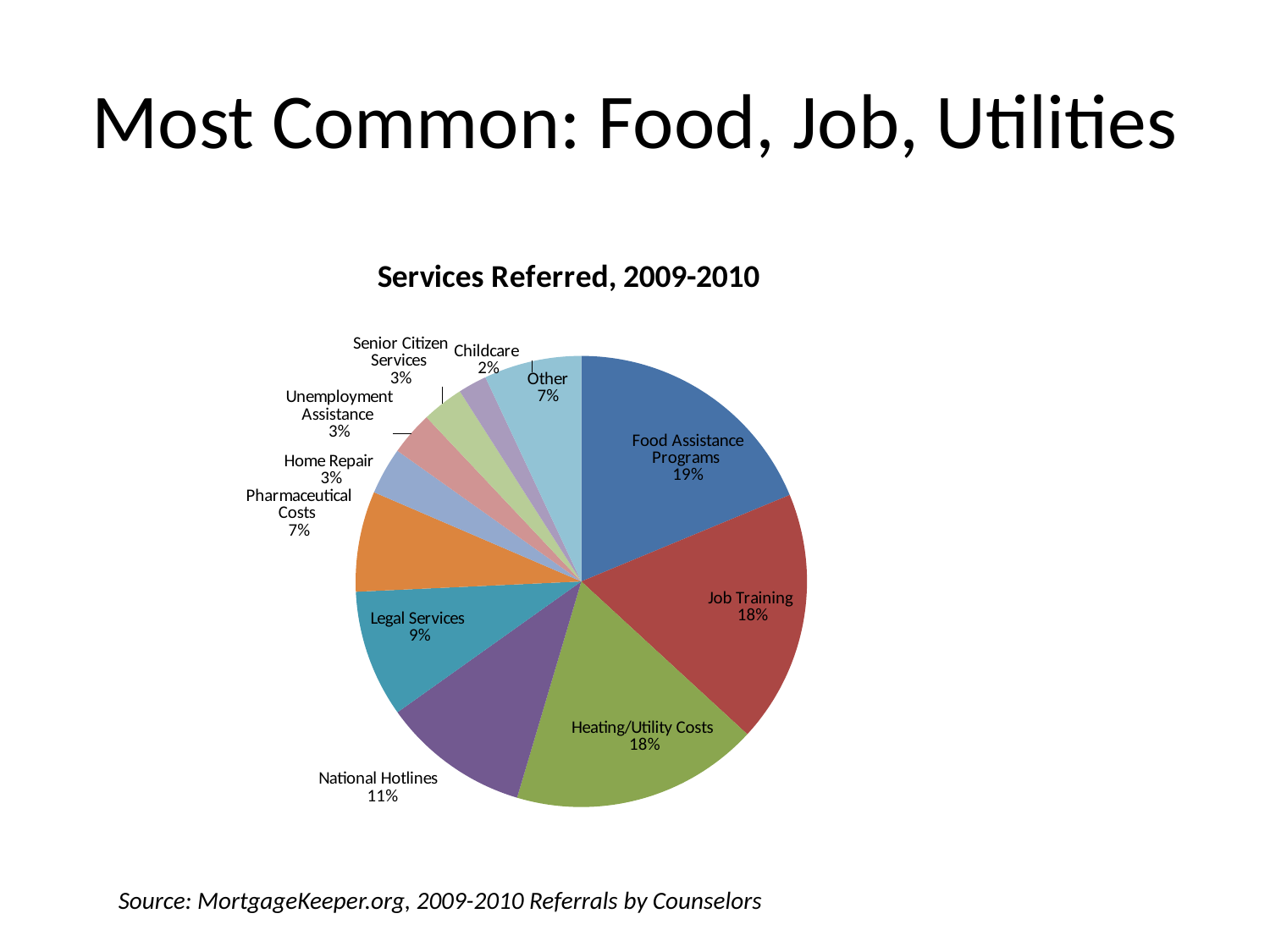
What is the title of the chart? Services Referred, 2009-2010 What percentage is shown for National Hotlines? 11% Which category has the largest slice of the pie? Food Assistance Programs How many slices does the pie chart have? 11 Which is larger, the share for Pharmaceutical Costs or the share for Home Repair? Pharmaceutical Costs What percentage is shown for the Other slice? 7% What type of chart is shown on the slide? Pie chart What share of referrals went to Food Assistance Programs? 19% What percentage is shown for Legal Services? 9% Which category has the smallest slice of the pie? Childcare What is the difference in percentage points between Food Assistance Programs and Legal Services? 10 What percentage of the pie is Job Training? 18%